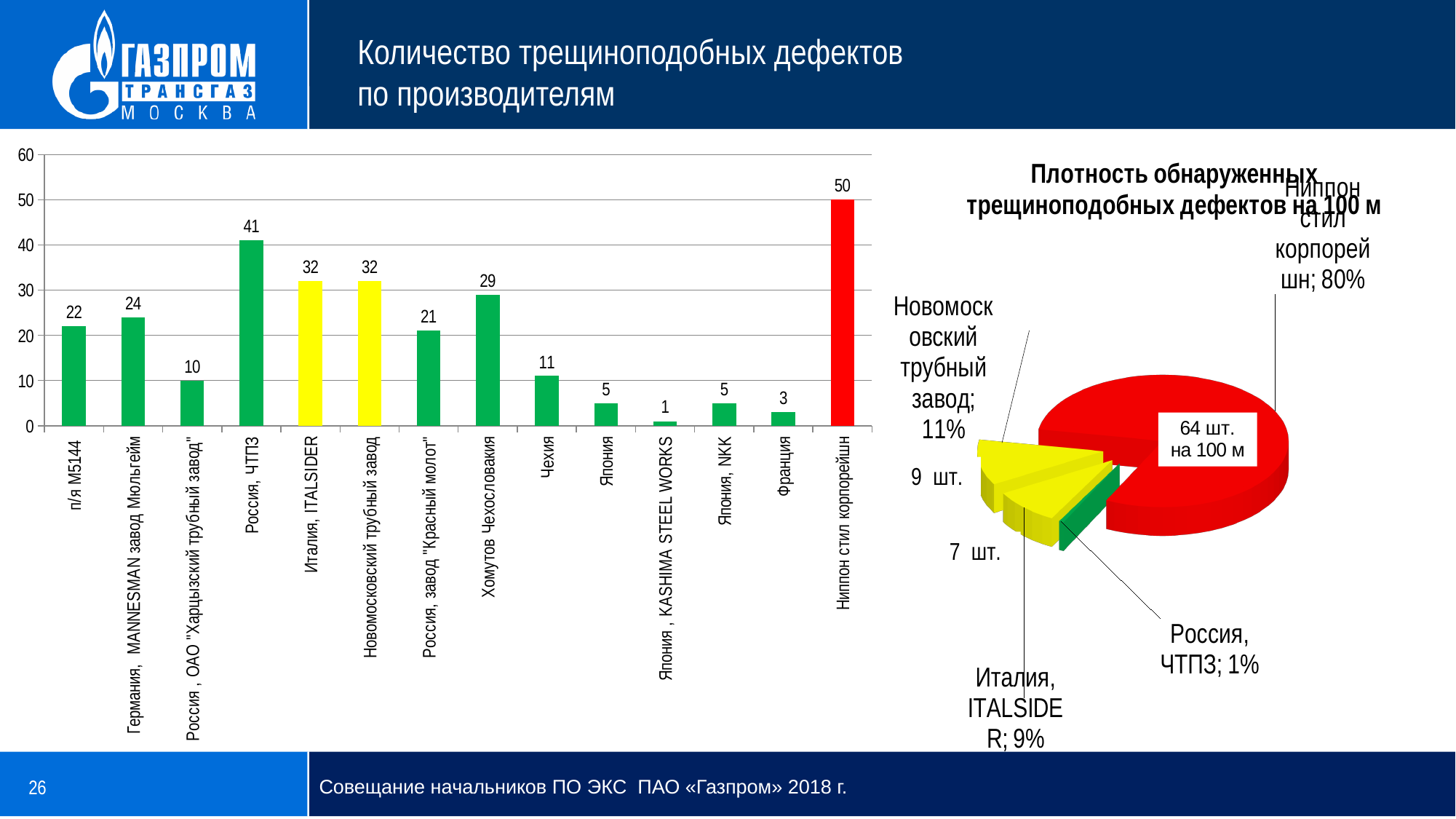
On the left bar chart, what is the value for Россия, ЧТПЗ? 41 On the left bar chart, what is the value for Ниппон стил корпорейшн? 50 On the left bar chart, which manufacturer has the highest number of defects? Ниппон стил корпорейшн On the pie chart on the right, what share does Ниппон стил корпорейшн have? 80% On the left bar chart, what is the difference between the values for Ниппон стил корпорейшн and Россия, ЧТПЗ? 9 On the left bar chart, which is larger: the value for п/я М5144 or the value for Германия, MANNESMAN завод Мюльгейм? Германия, MANNESMAN завод Мюльгейм On the left bar chart, how many manufacturers (bars) are shown? 14 On the left bar chart, what is the value for Хомутов Чехословакия? 29 On the left bar chart, which manufacturer has the lowest number of defects? Япония, KASHIMA STEEL WORKS On the pie chart on the right, what share does Италия, ITALSIDER have? 9% What type of chart is the chart on the left of the slide? Bar chart What is the title of the pie chart on the right? Плотность обнаруженных трещиноподобных дефектов на 100 м